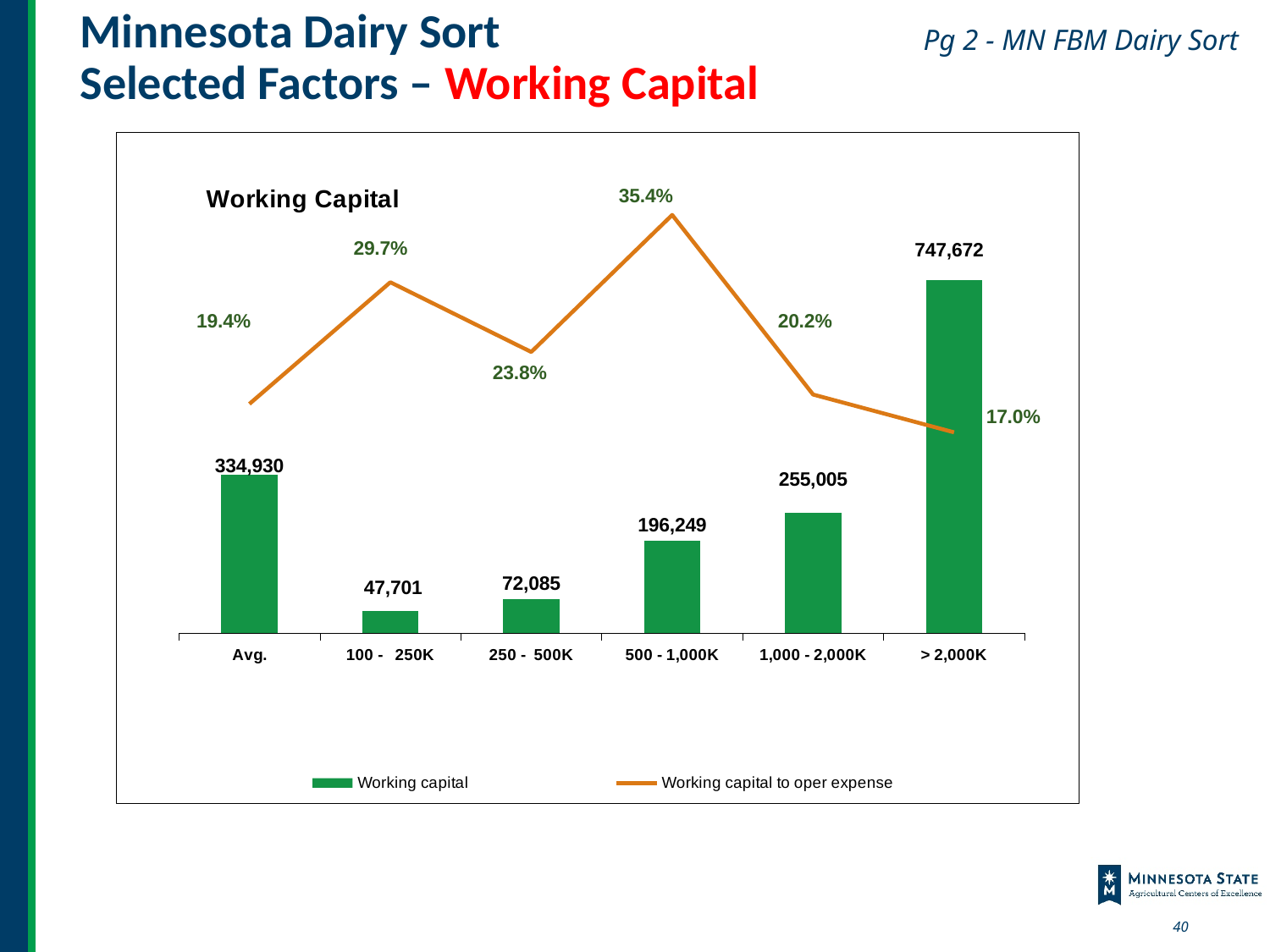
How many categories are shown on the x axis? 6 Which category has the lowest Working capital? 100 - 250K Which category has the lowest Working capital to oper expense? > 2,000K How many series does the legend list? 2 What is the Working capital value for the 100 - 250K category? 47,701 What is the Working capital value for the > 2,000K category? 747,672 What is the difference in Working capital between the 1,000 - 2,000K and 500 - 1,000K categories? 58,756 What is the Working capital to oper expense value for the 500 - 1,000K category? 35.4% What is the Working capital to oper expense value for the Avg. category? 19.4% What kind of chart is shown? Combined bar and line chart Which category has the highest Working capital? > 2,000K Which is larger, the Working capital for Avg. or for 1,000 - 2,000K? Avg.